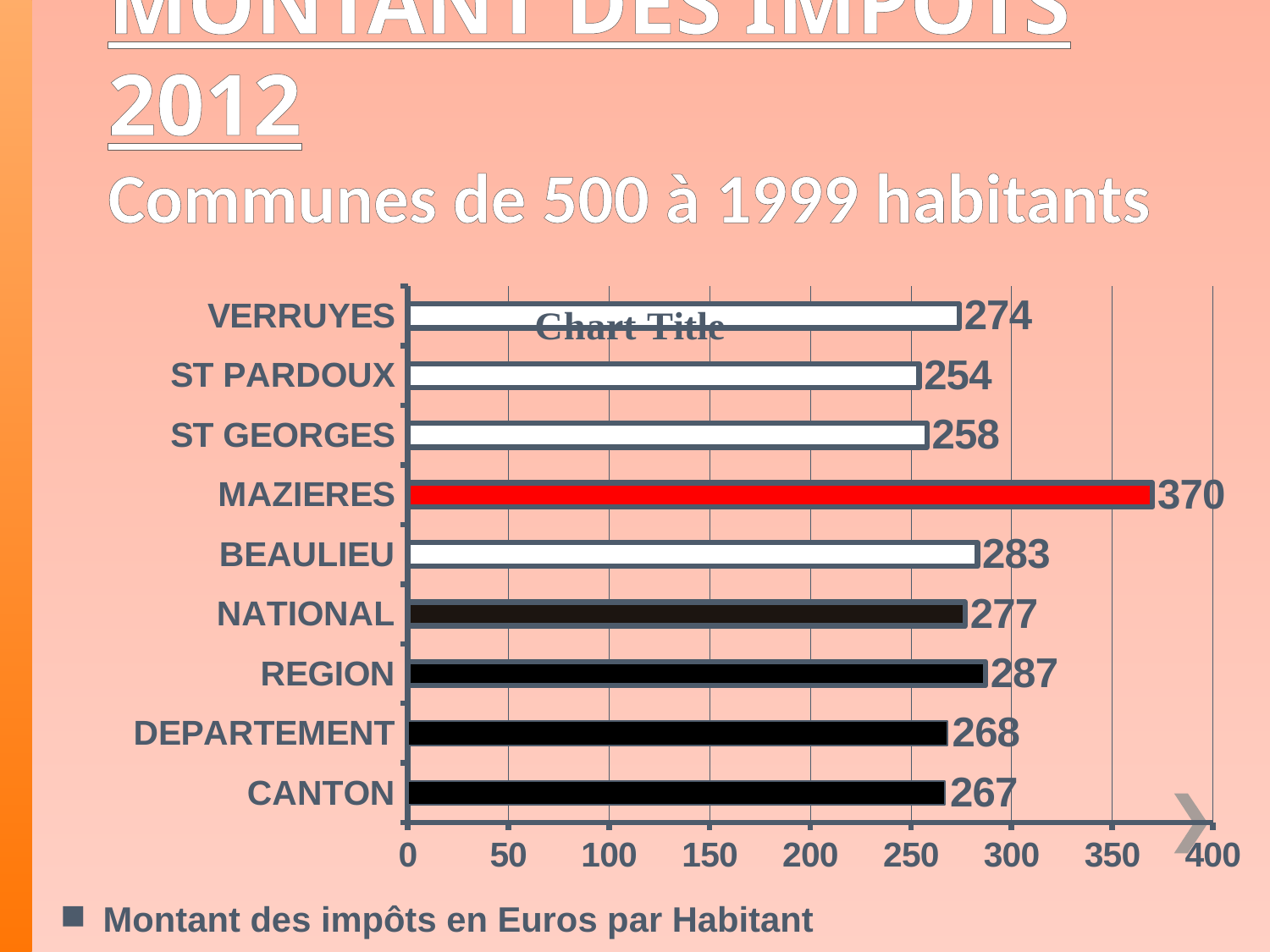
What is the difference between the values for MAZIERES and BEAULIEU? 87 What is the value for MAZIERES? 370 Which category has the highest value? MAZIERES How many categories are shown in the chart? 9 What kind of chart is shown on the slide? bar chart Is the value for NATIONAL greater or less than 250? greater Which bar is coloured red? MAZIERES Which is larger, the value for ST GEORGES or the value for ST PARDOUX? ST GEORGES What is the value for CANTON? 267 What is the value for VERRUYES? 274 Which category has the lowest value? ST PARDOUX What is the difference between the values for REGION and DEPARTEMENT? 19